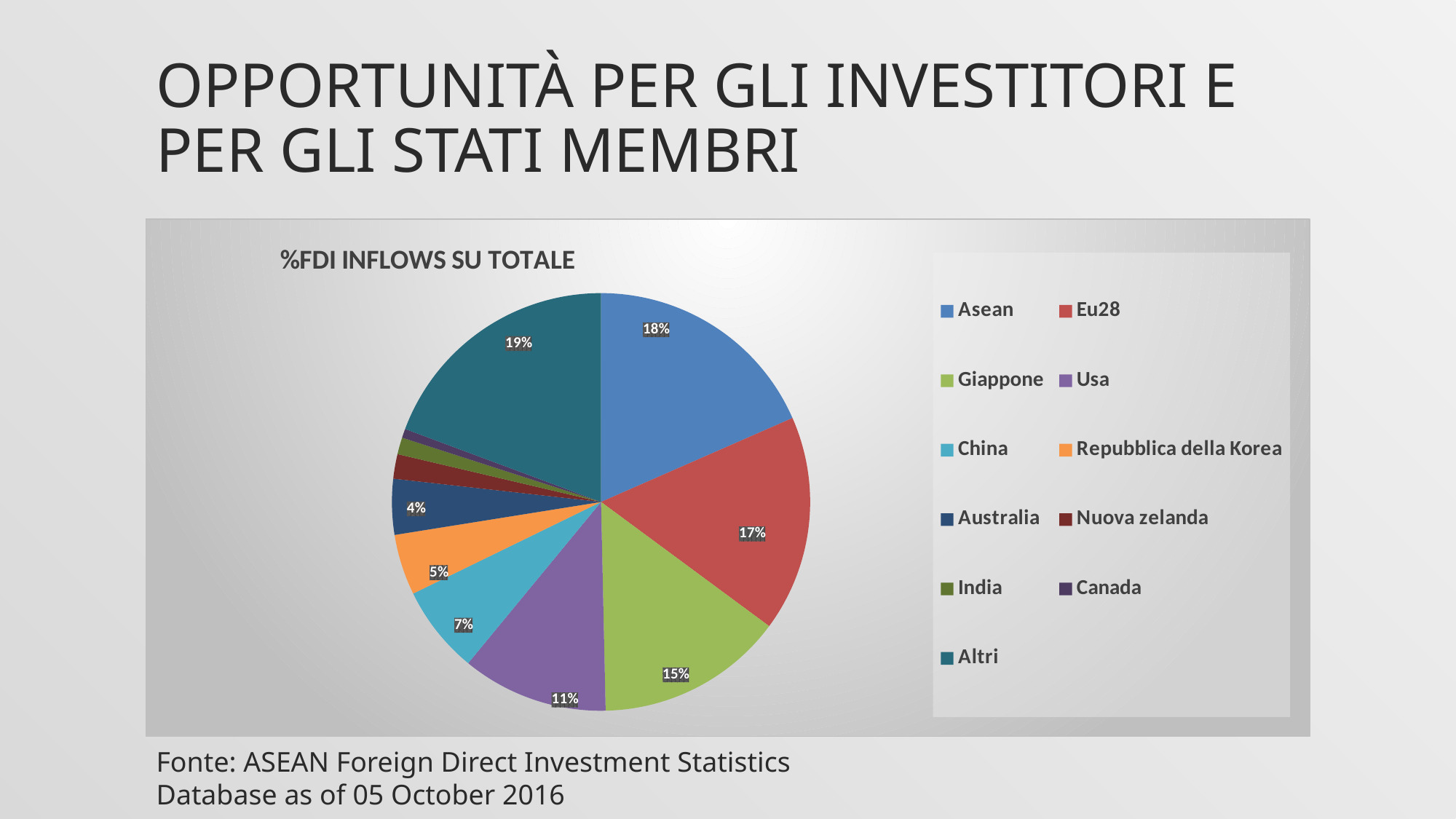
What is the difference in percentage points between the Asean and Eu28 slices? 1 How many categories does the legend list? 11 What is the title of the chart? %FDI INFLOWS SU TOTALE Which category has the largest slice of the pie? Altri What is the value shown for China? 7% What is the value shown for Eu28? 17% What is the value shown for Australia? 4% What percentage of FDI inflows does the Asean slice represent? 18% What type of chart is shown on the slide? pie chart What is the value shown for Usa? 11% What is the value shown for Repubblica della Korea? 5% What is the value shown for Giappone? 15%